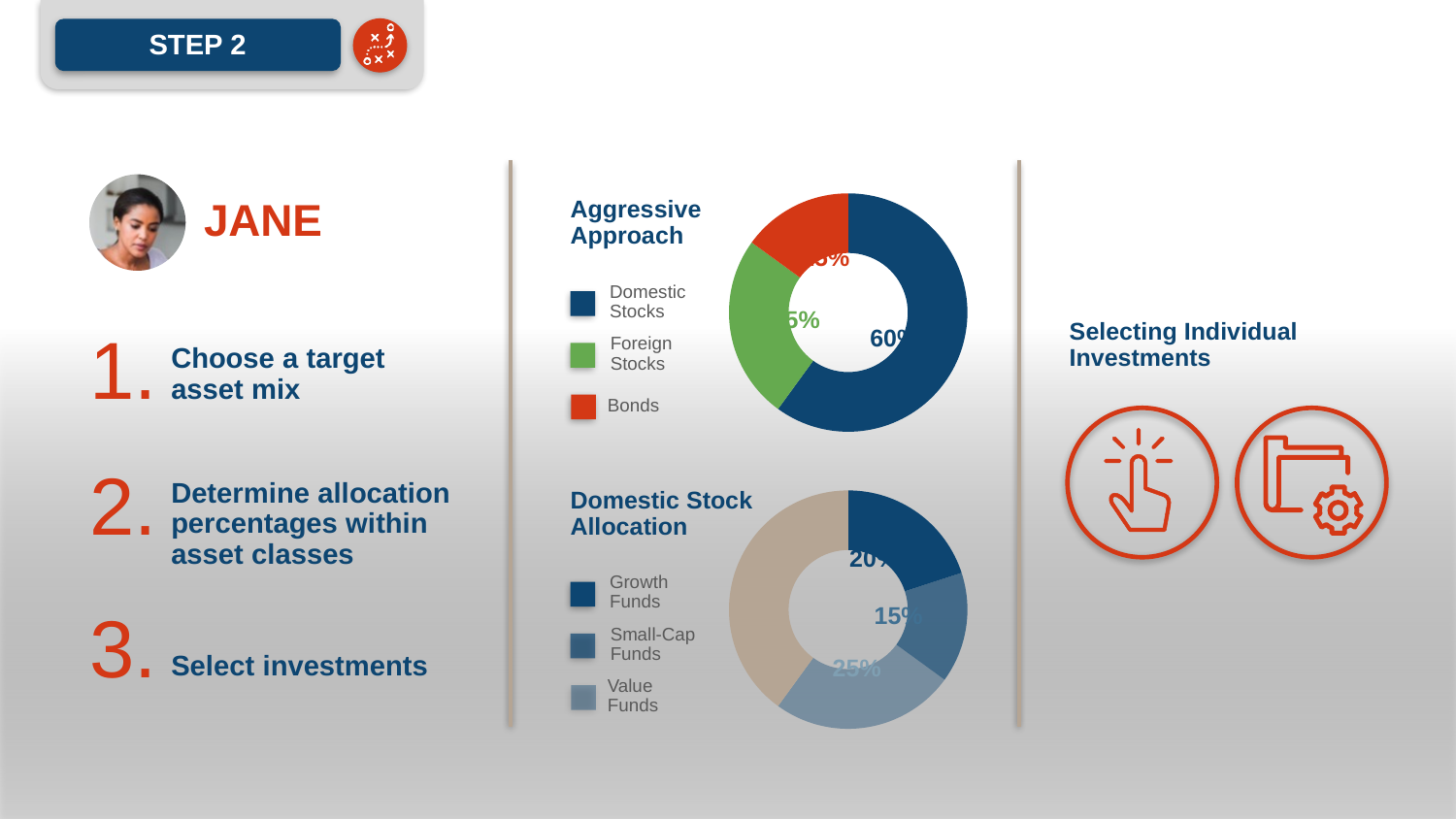
In the Aggressive Approach chart, which category has the largest share? Domestic Stocks How many categories does the legend of the Aggressive Approach chart list? 3 In the Domestic Stock Allocation chart, which is larger: Value Funds or Small-Cap Funds? Value Funds In the Domestic Stock Allocation chart, what share is shown for Value Funds? 25% What kind of chart is the Domestic Stock Allocation chart? Donut (pie) chart What kind of chart is the Aggressive Approach chart? Donut (pie) chart In the Aggressive Approach chart, which is larger: Foreign Stocks or Bonds? Foreign Stocks In the Aggressive Approach chart, what colour represents Bonds? Red In the Aggressive Approach chart, which category has the smallest share? Bonds How many categories does the legend of the Domestic Stock Allocation chart list? 3 In the Domestic Stock Allocation chart, what share is shown for Small-Cap Funds? 15% In the Aggressive Approach chart, what share is shown for Domestic Stocks? 60%